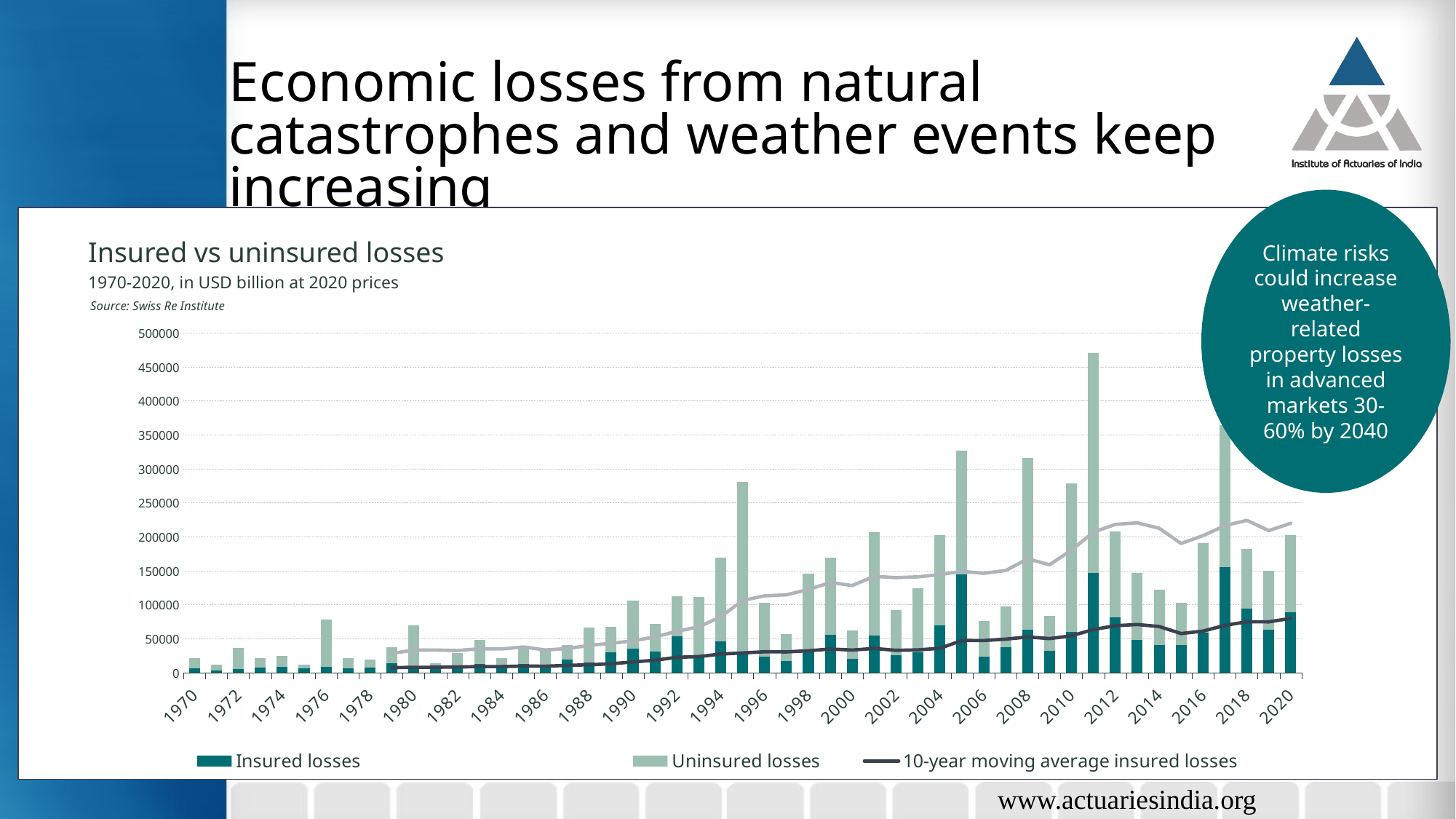
Does the 10-year moving average insured losses line generally rise or fall from 1980 to 2020? rise Is the total losses bar for 1970 greater or less than 50000? less Is the total losses bar for 2011 greater or less than 450000? greater Is the total losses bar for 2005 greater or less than 300000? greater What kind of chart is shown on the slide? Stacked bar chart with a line overlay What source is cited for the chart? Swiss Re Institute Which year has the tallest total losses bar? 2011 What is the title of the chart? Insured vs uninsured losses How many series does the chart legend list? 3 Which year has the larger total losses bar, 1995 or 2004? 1995